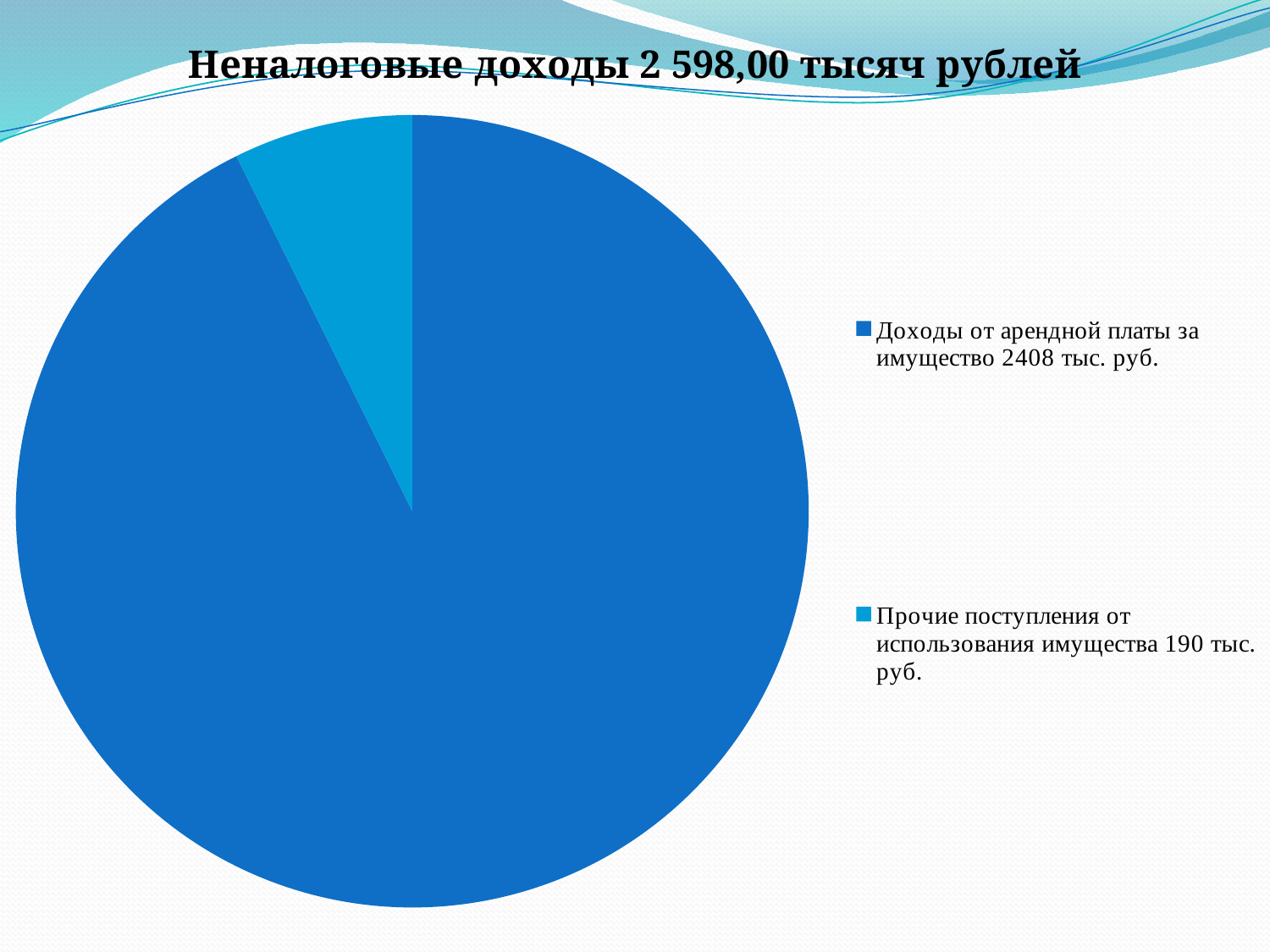
What share of the total non-tax income does 'Прочие поступления от использования имущества' (190 of 2598 тыс. руб.) represent, to one decimal place? 7.3% How many slices does the pie chart have? 2 What kind of chart is shown on the slide? Pie chart What is the value for 'Прочие поступления от использования имущества' according to the legend? 190 тыс. руб. What colour is the slice for 'Прочие поступления от использования имущества'? Light blue What is the difference in тыс. руб. between 'Доходы от арендной платы за имущество' and 'Прочие поступления от использования имущества'? 2218 тыс. руб. Which category has the smallest slice of the pie? Прочие поступления от использования имущества What is the title of the chart on the slide? Неналоговые доходы 2 598,00 тысяч рублей What is the value for 'Доходы от арендной платы за имущество' according to the legend? 2408 тыс. руб. Which category has the largest slice of the pie? Доходы от арендной платы за имущество Which is larger: income from property rent (Доходы от арендной платы за имущество) or other income from property use (Прочие поступления от использования имущества)? Доходы от арендной платы за имущество What is the total of the two categories shown in the pie chart, as stated in the title? 2 598,00 тысяч рублей